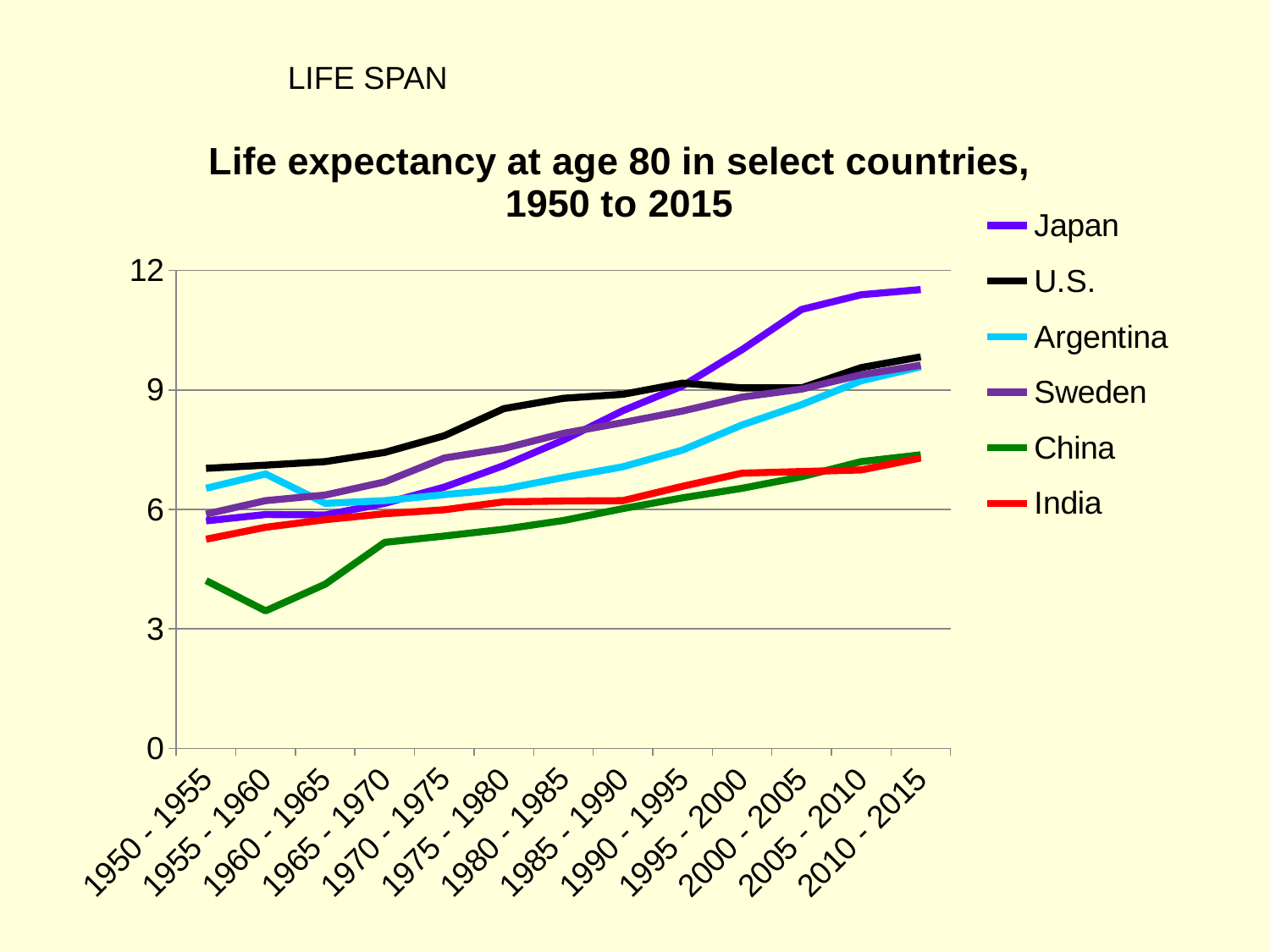
In 2010 - 2015, which is larger, the value for Japan or the value for the U.S.? Japan How many series does the legend list? 6 Does the line for Japan generally rise or fall from 1950 - 1955 to 2010 - 2015? rise Which country has the highest life expectancy at age 80 in the 2010 - 2015 period? Japan Is the value for India in 1950 - 1955 greater or less than 6? less What kind of chart is shown on the slide? line chart Is the value for China in 1955 - 1960 greater or less than 6? less How many time periods are shown along the x axis? 13 What is the title of the chart? Life expectancy at age 80 in select countries, 1950 to 2015 Which country has the highest life expectancy at age 80 in the 1950 - 1955 period? U.S. Is the value for Japan in 2010 - 2015 greater or less than 9? greater Which country has the lowest life expectancy at age 80 in the 1950 - 1955 period? China